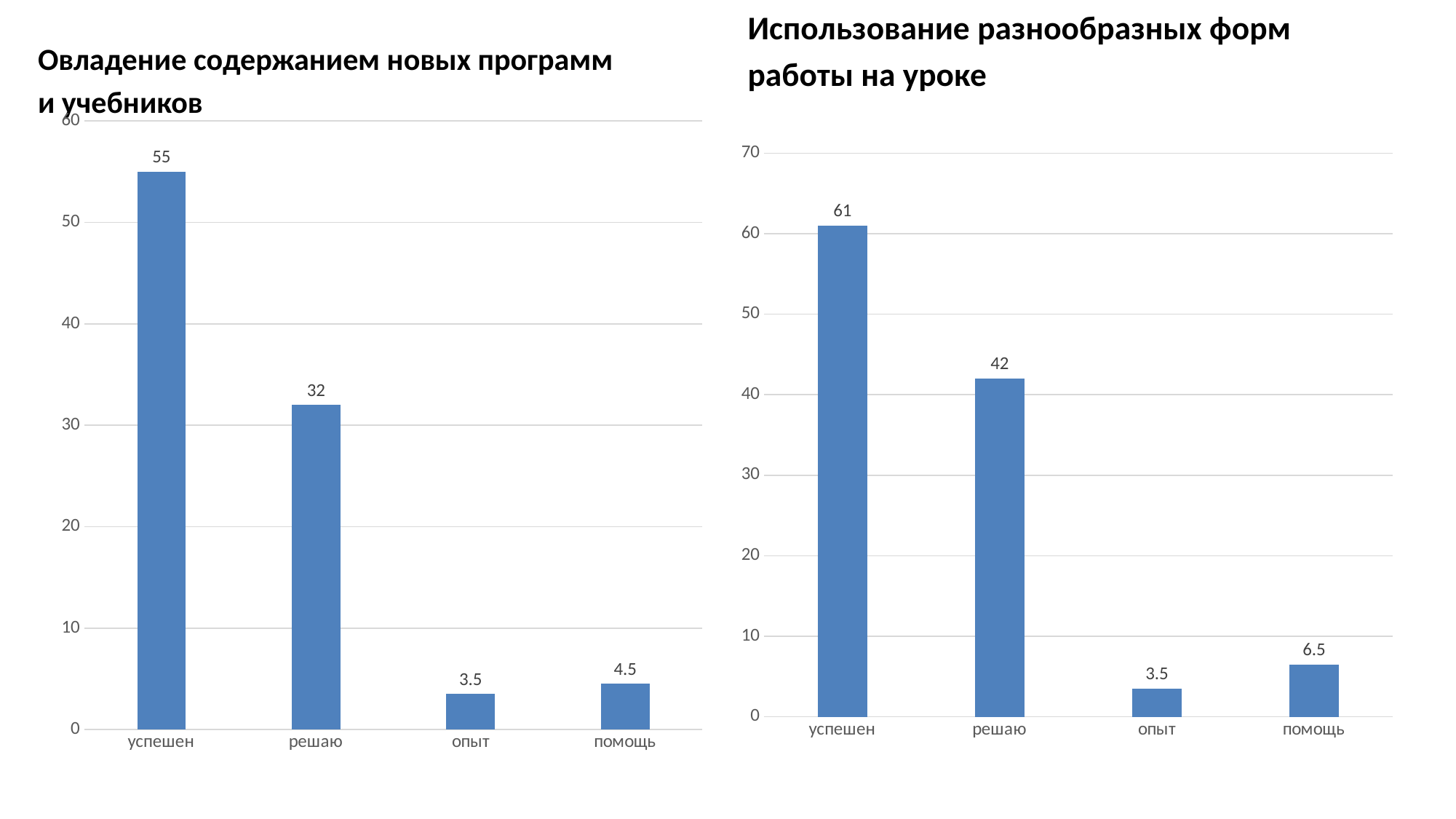
In the left chart (Овладение содержанием новых программ и учебников), what is the value for успешен? 55 In the left chart (Овладение содержанием новых программ и учебников), which category has the highest value? успешен In the left chart (Овладение содержанием новых программ и учебников), which is larger: the value for опыт or the value for помощь? помощь In the right chart (Использование разнообразных форм работы на уроке), which category has the lowest value? опыт In the right chart (Использование разнообразных форм работы на уроке), what is the value for решаю? 42 What kind of chart is the right chart (Использование разнообразных форм работы на уроке)? bar chart In the left chart (Овладение содержанием новых программ и учебников), what is the difference between the values for успешен and решаю? 23 In the right chart (Использование разнообразных форм работы на уроке), is the value for успешен greater or less than 60? greater In the right chart (Использование разнообразных форм работы на уроке), what is the value for помощь? 6.5 In the right chart (Использование разнообразных форм работы на уроке), what is the difference between the values for успешен and решаю? 19 How many categories does the left chart (Овладение содержанием новых программ и учебников) show? 4 In the left chart (Овладение содержанием новых программ и учебников), what is the value for опыт? 3.5